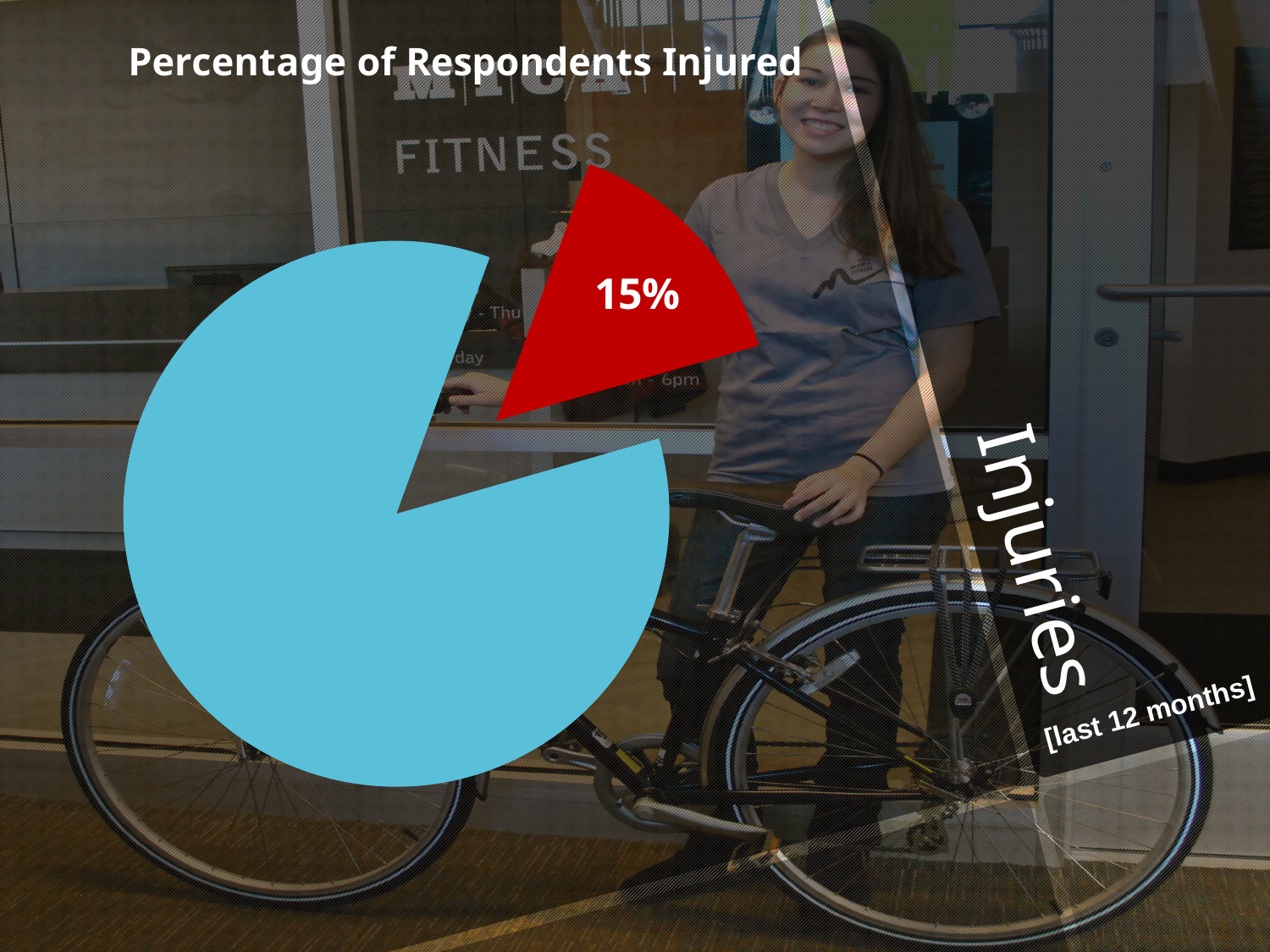
What percentage is printed on the red slice of the pie chart? 15% What kind of chart is shown on the slide? pie chart Which slice of the pie chart is larger, the red slice or the blue slice? the blue slice What is the title of the chart? Percentage of Respondents Injured What colour is the slice labelled 15%? red How many slices does the pie chart have? 2 Which slice of the pie chart is the smallest? the red slice (15%) What share of the pie does the red slice represent? 15%